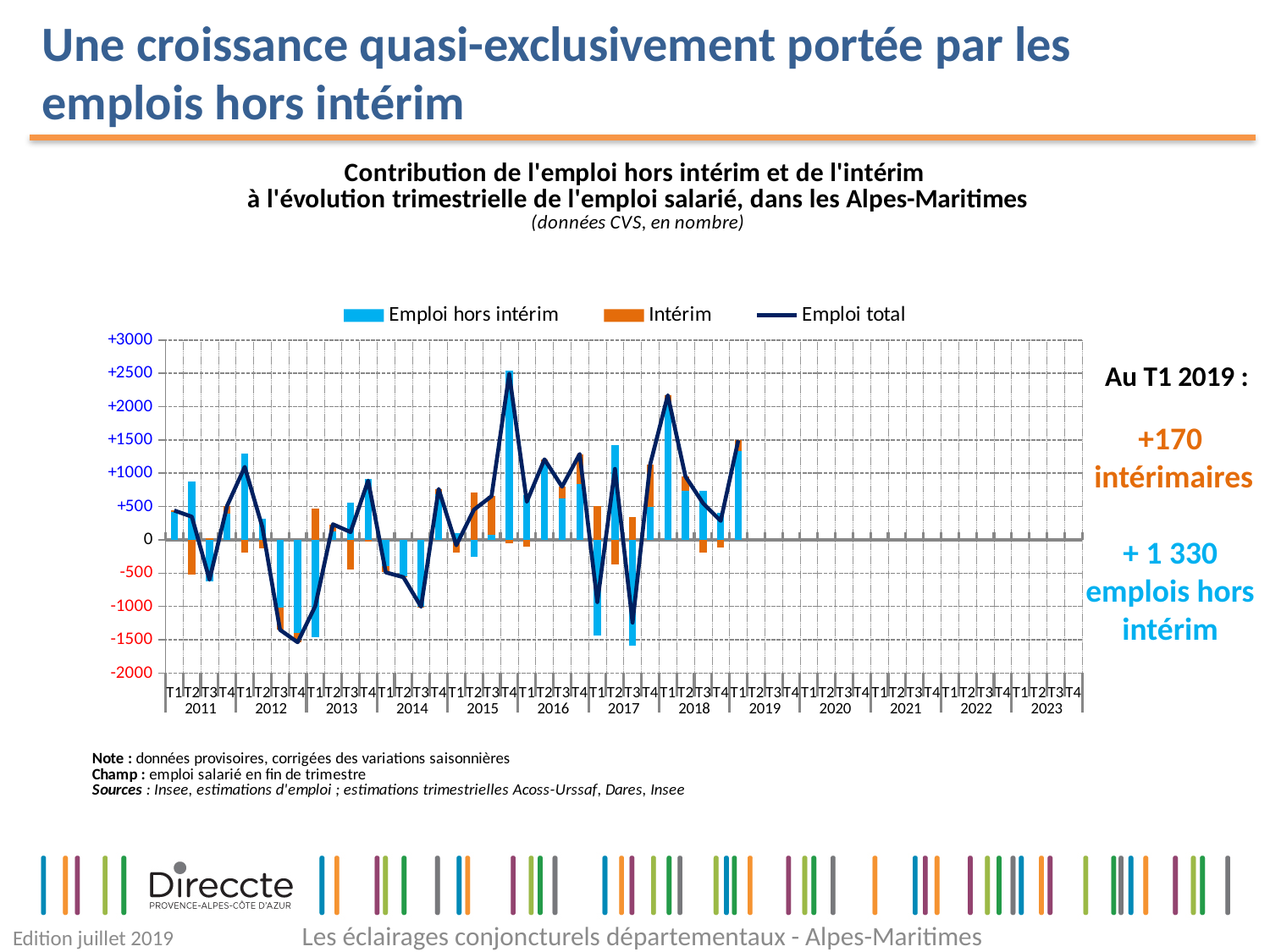
According to the annotation on the slide, what is the contribution of intérim (temporary work) to employment growth in T1 2019? +170 Is the Emploi total value in T2 2015 greater or less than +2000? less In which quarter does the Emploi total line reach its lowest value? T4 2012 How many years are labelled on the x axis of the chart? 13 In T1 2019, which contributes more to employment growth: emploi hors intérim or intérim? Emploi hors intérim According to the annotation on the slide, what is the contribution of emploi hors intérim in T1 2019? + 1 330 In which quarter does the Emploi total line reach its highest value? T4 2015 Which series is drawn as a dark blue line in the chart? Emploi total How many series does the legend list? 3 Is the Emploi total value in T2 2012 greater or less than -1000? greater What kind of chart is shown on the slide? A bar chart combined with a line chart Using the values printed for T1 2019, what is the total of the intérim and hors intérim contributions? 1 500